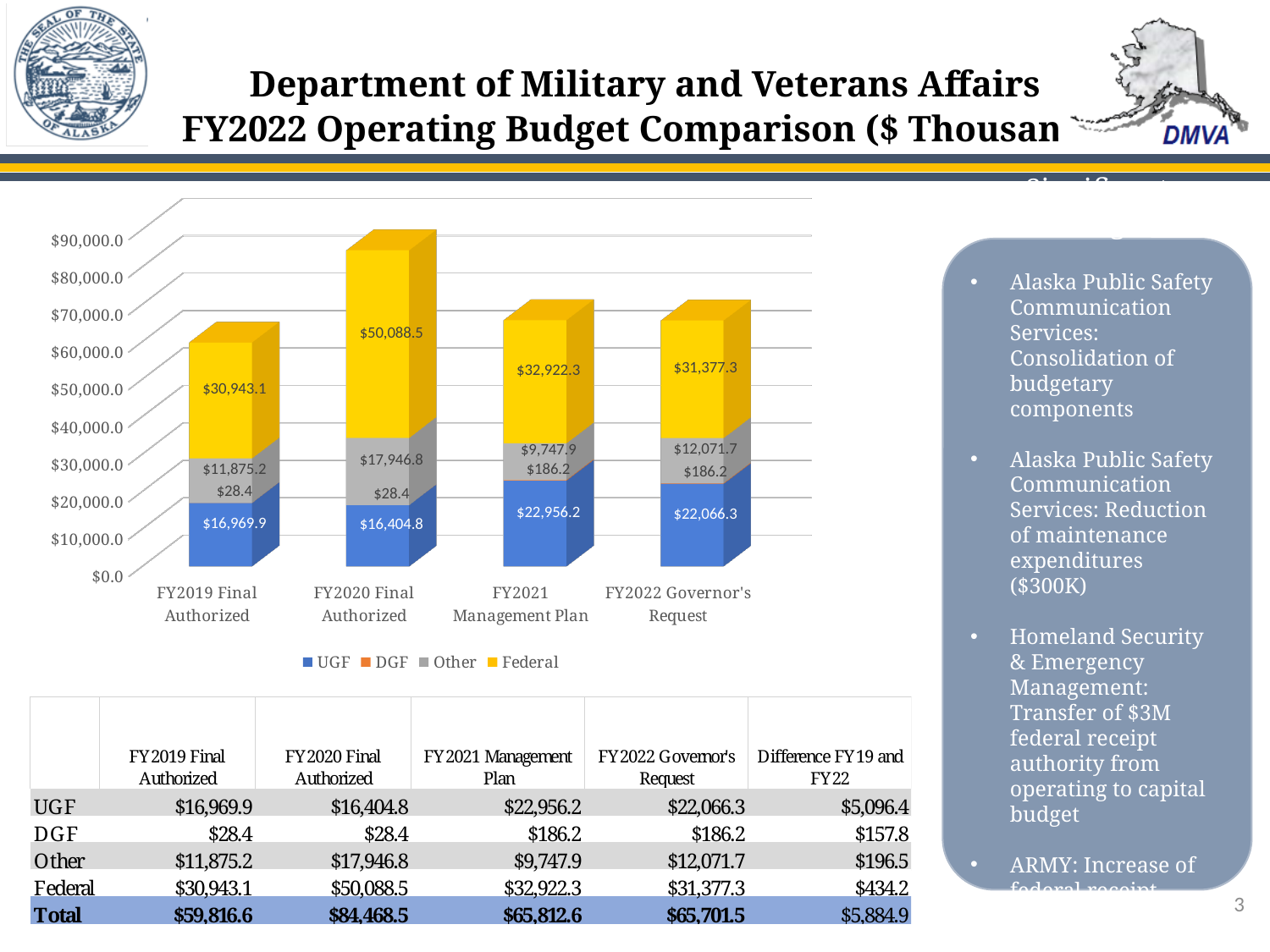
What is the Federal value for FY2020 Final Authorized? $50,088.5 Which is larger, the UGF value for FY2021 Management Plan or for FY2022 Governor's Request? FY2021 Management Plan How many categories are shown on the x axis? 4 What is the difference between the Federal values for FY2020 Final Authorized and FY2019 Final Authorized? $19,145.4 How many series does the legend list? 4 What is the UGF value for FY2021 Management Plan? $22,956.2 Is the total stacked value for FY2020 Final Authorized greater or less than $80,000.0? greater What is the Other value for FY2022 Governor's Request? $12,071.7 Which category has the highest Federal value? FY2020 Final Authorized What is the DGF value for FY2019 Final Authorized? $28.4 What is the total of the stacked bar for FY2019 Final Authorized? $59,816.6 Which category has the lowest UGF value? FY2020 Final Authorized